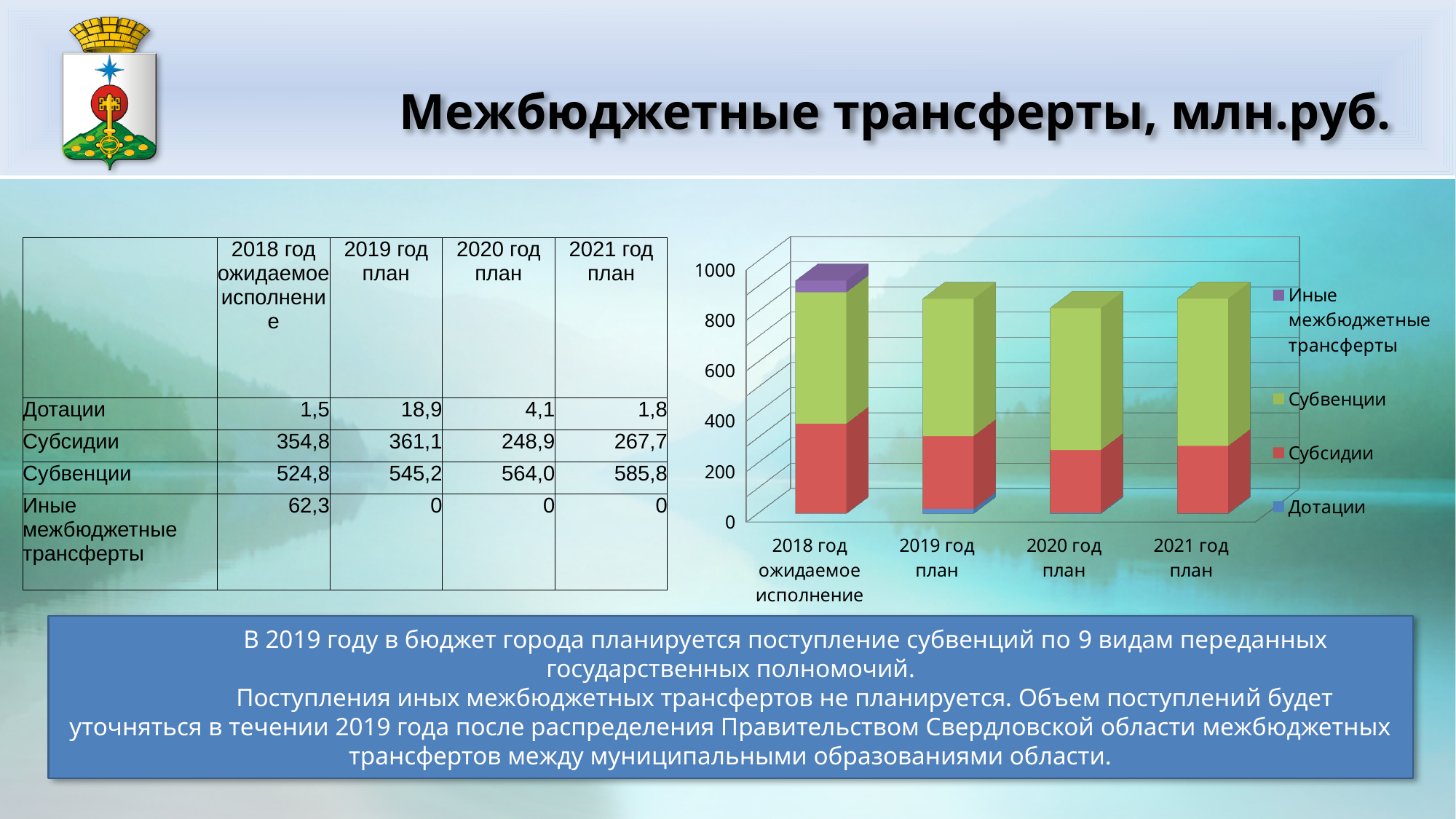
Do the values of Субвенции rise or fall from 2018 to 2021 along the x axis? rise In which year is the value of Субсидии the lowest? 2020 год план Is the total height of the stacked bar for 2020 год план greater or less than 1000? less By how much does Субвенции for 2021 год план exceed Субвенции for 2018 год ожидаемое исполнение? 61,0 What is the value of Субвенции for 2021 год план? 585,8 What is the total of the stacked bar for 2018 год ожидаемое исполнение? 943,4 How many year categories are shown on the x axis of the chart? 4 In which year is the value of Субвенции the highest? 2021 год план What is the value of Субсидии for 2018 год ожидаемое исполнение? 354,8 What kind of chart is shown on the slide? stacked bar chart How many series does the chart legend list? 4 Which is larger: Субсидии for 2019 год план or Субсидии for 2020 год план? 2019 год план